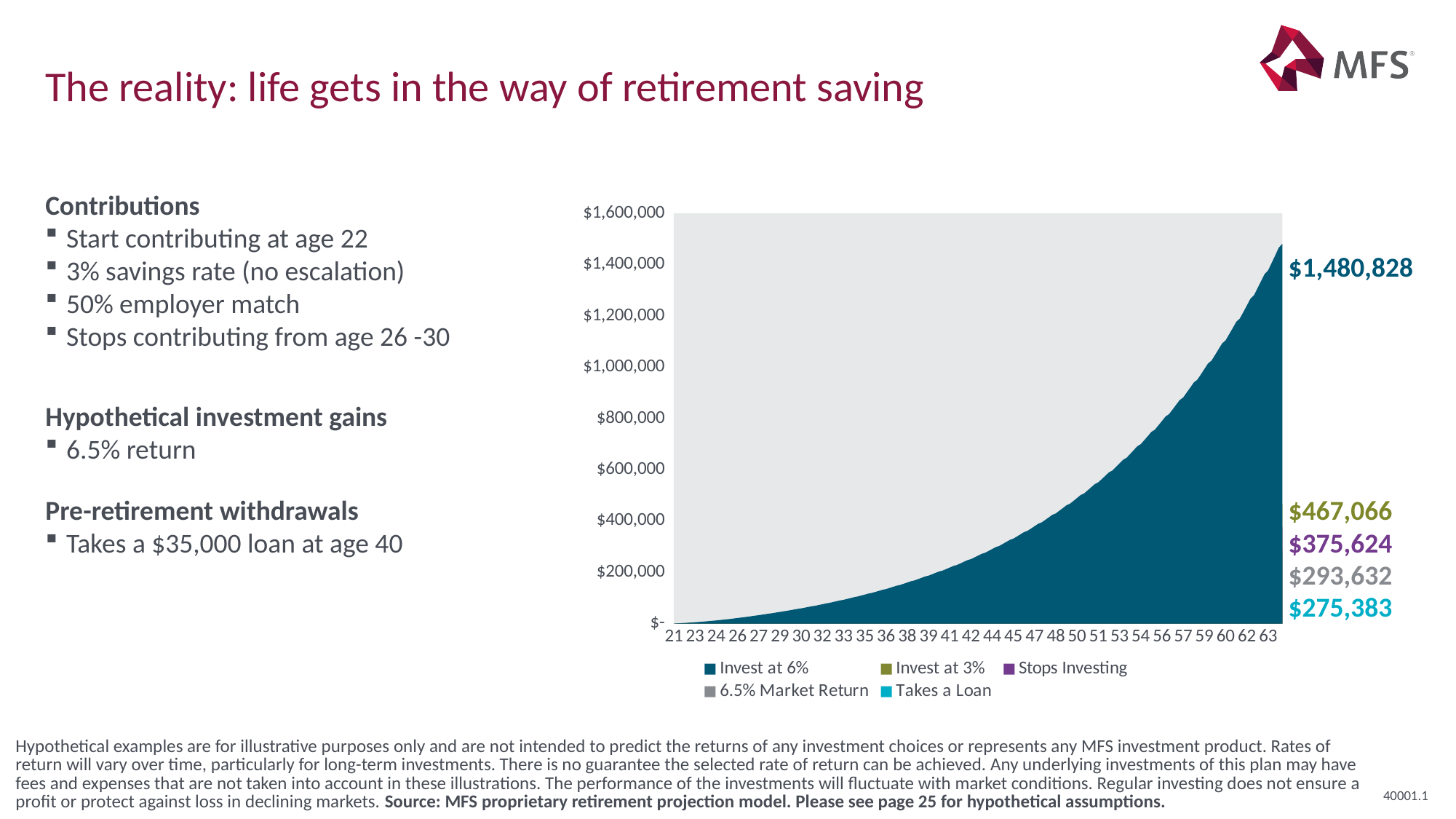
Which series has the highest final value labeled on the chart? Invest at 6% Which has a larger final value, Stops Investing or 6.5% Market Return? Stops Investing Is the value of the Invest at 6% series at age 60 greater or less than $1,000,000? greater What is the final value shown for the Invest at 6% series? $1,480,828 What is the difference between the final values for Invest at 6% and Invest at 3%? $1,013,762 Which series has the lowest final value labeled on the chart? Takes a Loan What kind of chart is shown on the slide? Area chart What is the final value shown for the Stops Investing series? $375,624 How many series does the legend list? 5 What is the difference between the final values for 6.5% Market Return and Takes a Loan? $18,249 What is the final value shown for the Takes a Loan series? $275,383 Is the value of the Invest at 6% series at age 38 greater or less than $200,000? less